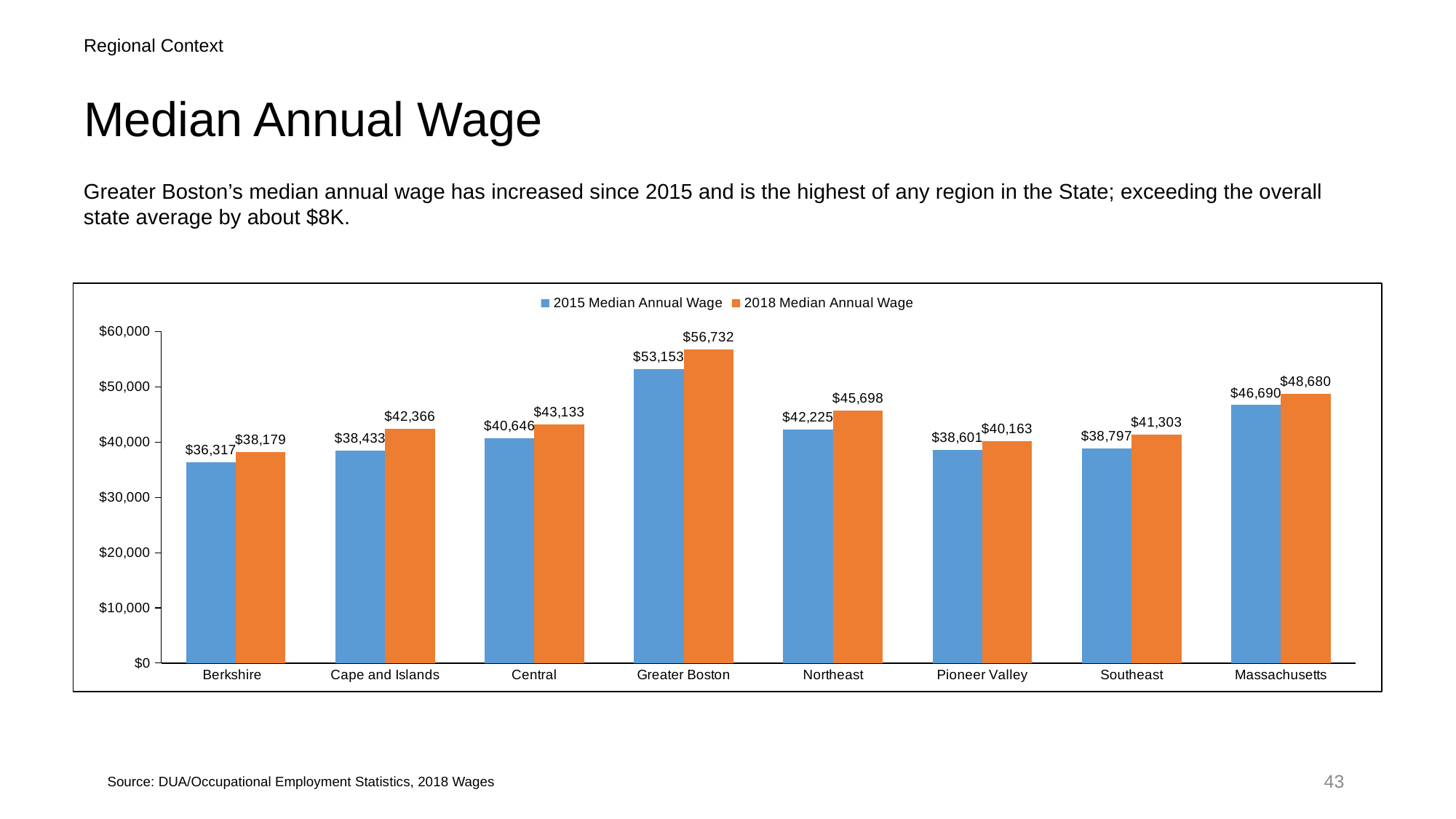
Is the 2018 Median Annual Wage for Pioneer Valley greater or less than $40,000? greater How many regions are shown on the x axis? 8 What is the 2015 Median Annual Wage for Berkshire? $36,317 Which region has the highest 2018 Median Annual Wage? Greater Boston What is the 2018 Median Annual Wage for Massachusetts? $48,680 How many series does the legend list? 2 Which is larger, the 2015 Median Annual Wage for Northeast or for Central? Northeast What is the difference between the 2018 Median Annual Wage for Greater Boston and for Massachusetts? $8,052 What kind of chart is shown on the slide? Bar chart Which region has the lowest 2015 Median Annual Wage? Berkshire What is the difference between the 2018 and 2015 Median Annual Wage for Greater Boston? $3,579 What is the 2018 Median Annual Wage for Greater Boston? $56,732